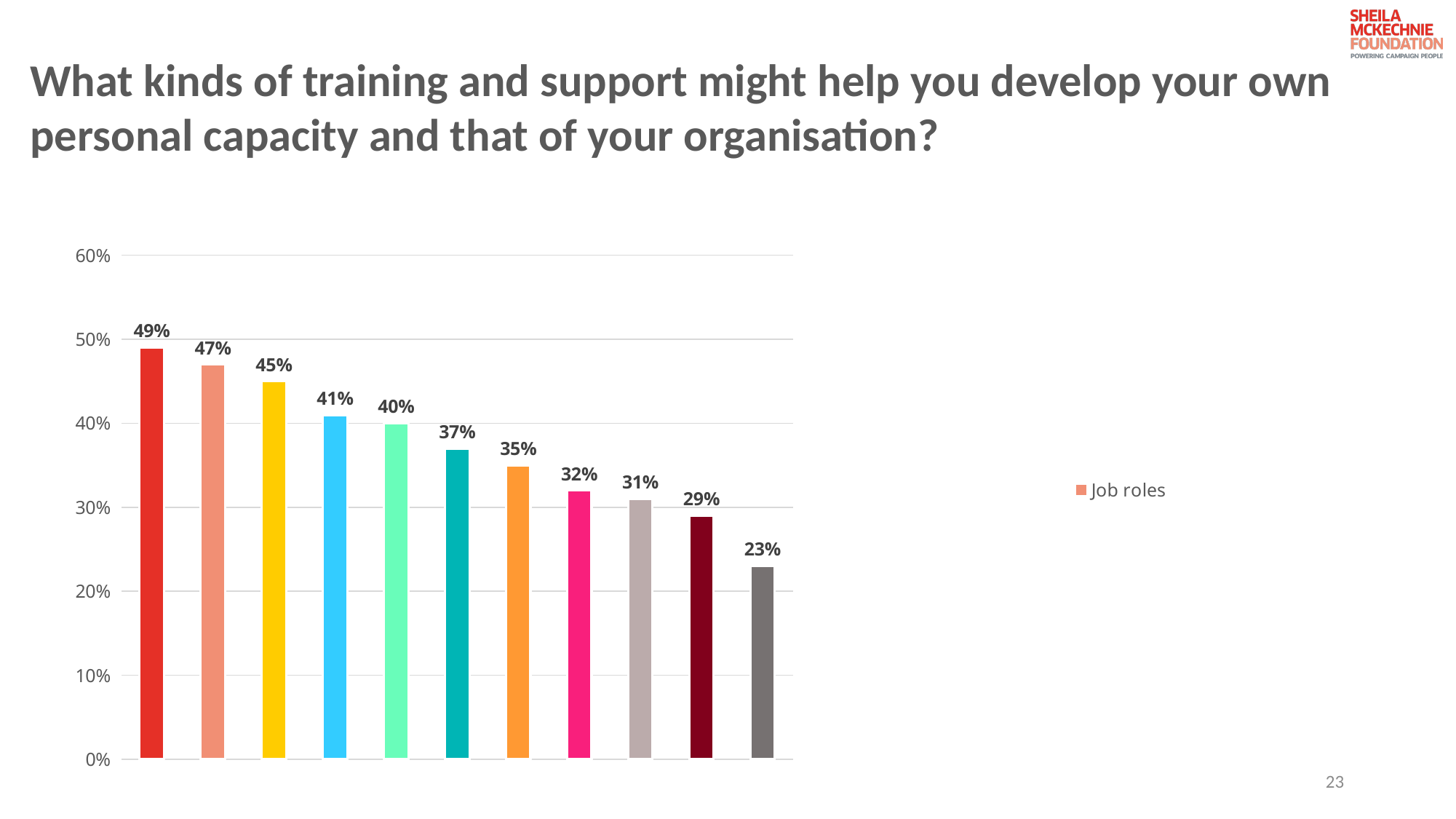
Which is larger: the value of the light blue bar or the value of the teal bar? the light blue bar (41%) What is the value of the tallest bar in the chart? 49% Is the value of the dark red bar, second from the right, greater or less than 30%? less How many bars are plotted in the chart? 11 What type of chart is shown on the slide? bar chart What is the name of the series shown in the chart legend? Job roles What is the value of the pink bar, the eighth from the left? 32% Do the bar values rise or fall from left to right across the chart? fall How many series does the legend list? 1 What is the value of the third bar from the left (the yellow bar)? 45% What is the difference between the first bar (49%) and the last bar (23%)? 26% What is the value of the shortest bar in the chart? 23%